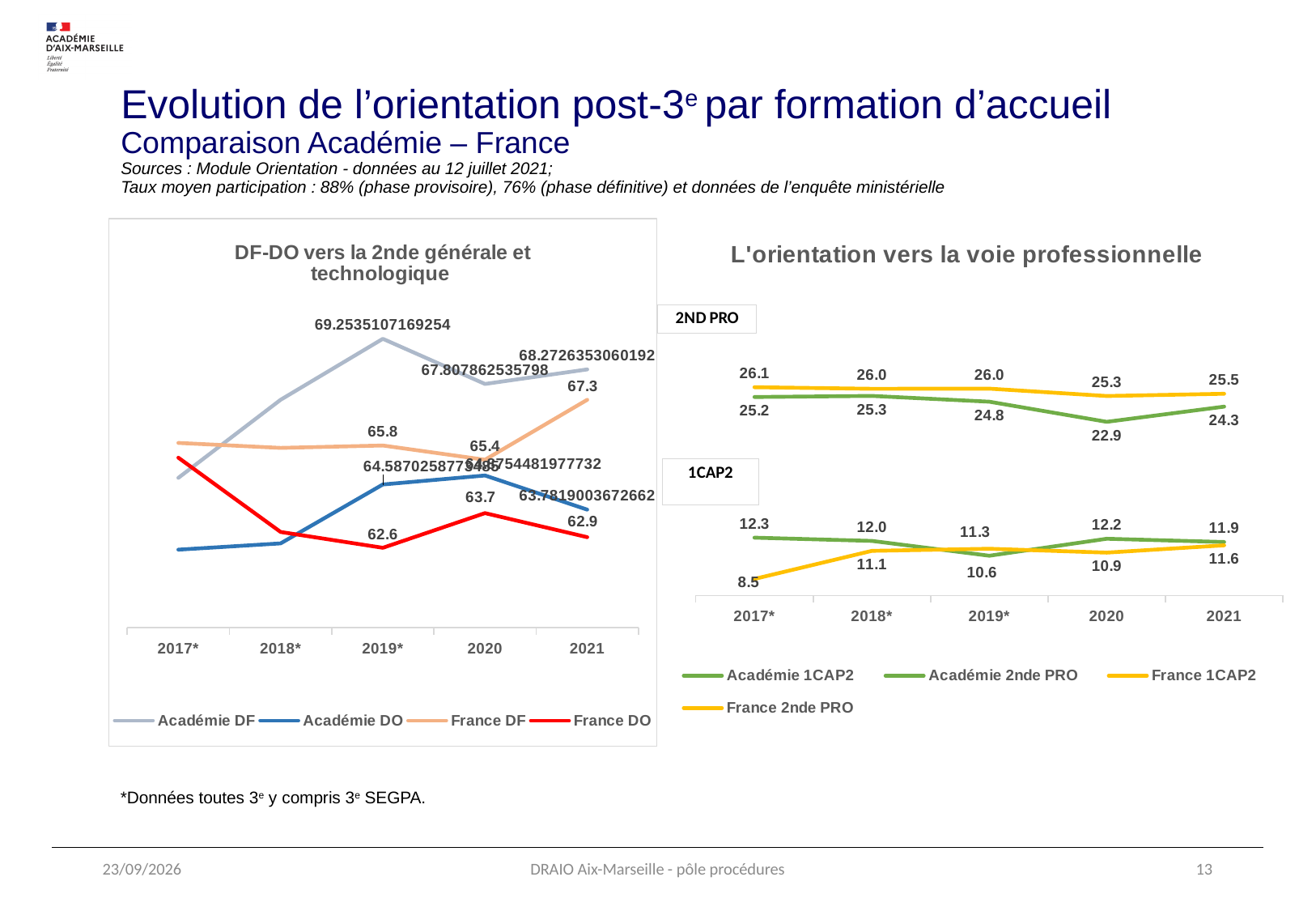
In the chart 'L'orientation vers la voie professionnelle', what is the difference between Académie 1CAP2 and France 1CAP2 in 2017*? 3.8 In the chart 'DF-DO vers la 2nde générale et technologique', what is the difference between France DF and France DO in 2021? 4.4 How many years are shown on the x axis of the chart 'L'orientation vers la voie professionnelle'? 5 In the chart 'DF-DO vers la 2nde générale et technologique', what is the value for France DF in 2021? 67.3 In the chart 'L'orientation vers la voie professionnelle', in which year is Académie 2nde PRO lowest? 2020 In the chart 'DF-DO vers la 2nde générale et technologique', what is the value for Académie DF in 2019*? 69.2535107169254 In the chart 'DF-DO vers la 2nde générale et technologique', how many series does the legend list? 4 In the chart 'L'orientation vers la voie professionnelle', what is the value for France 2nde PRO in 2017*? 26.1 In the chart 'DF-DO vers la 2nde générale et technologique', in which year is Académie DF highest? 2019* In the chart 'DF-DO vers la 2nde générale et technologique', what is the value for France DO in 2019*? 62.6 What kind of chart is 'DF-DO vers la 2nde générale et technologique'? line chart In the chart 'L'orientation vers la voie professionnelle', which is larger in 2021: France 2nde PRO or Académie 2nde PRO? France 2nde PRO